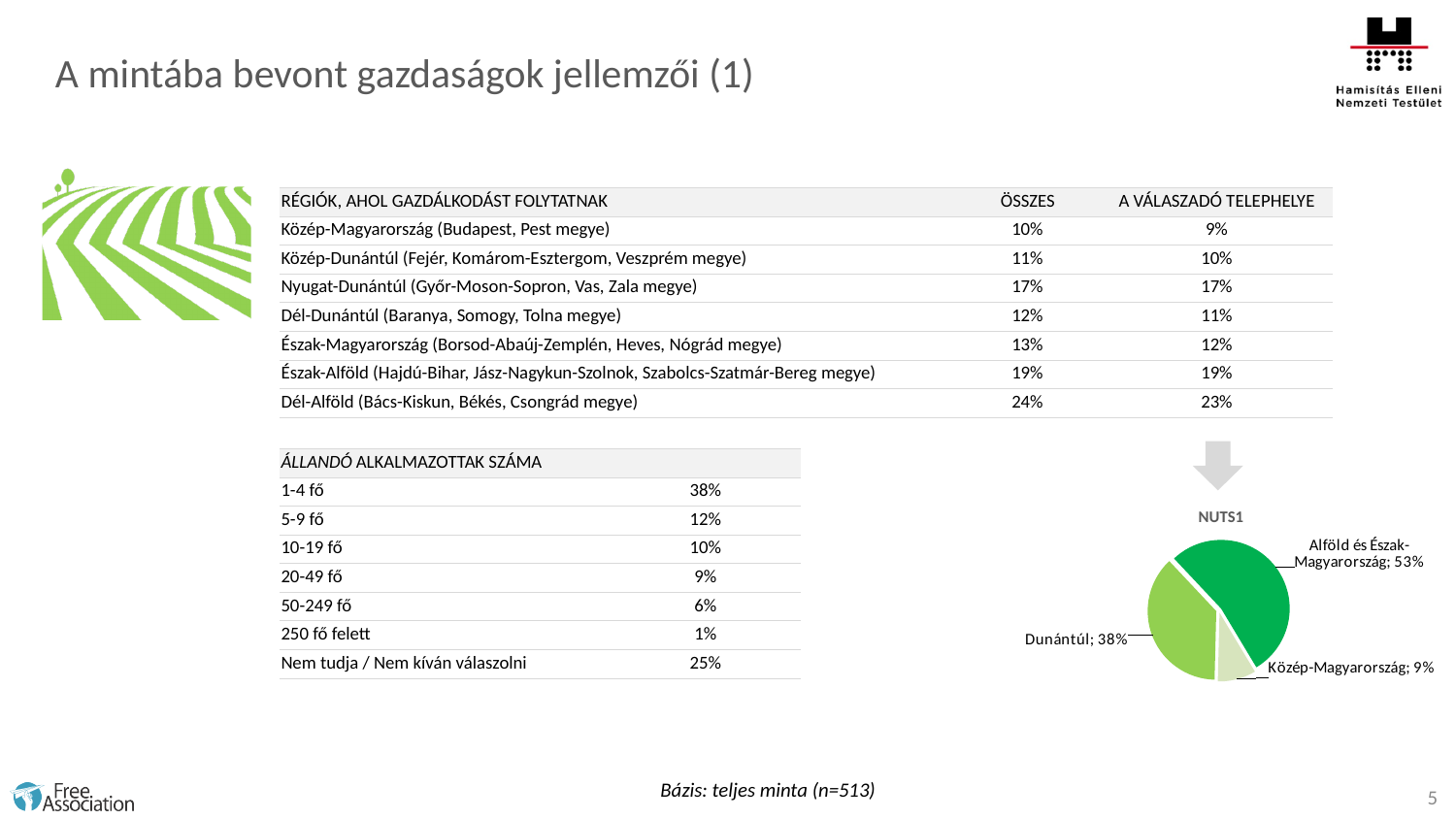
In the NUTS1 pie chart, what is the share for Dunántúl? 38% In the NUTS1 pie chart, what is the share for Közép-Magyarország? 9% Which slice of the NUTS1 pie chart is the largest? Alföld és Észak-Magyarország Which slice of the NUTS1 pie chart is the smallest? Közép-Magyarország What is the title of the pie chart on the slide? NUTS1 What kind of chart is shown under the NUTS1 heading? Pie chart In the NUTS1 pie chart, which is larger: Dunántúl or Közép-Magyarország? Dunántúl In the NUTS1 pie chart, what is the difference between the shares of Dunántúl and Közép-Magyarország? 29% In the NUTS1 pie chart, what is the share for Alföld és Észak-Magyarország? 53% In the NUTS1 pie chart, what is the difference between the shares of Alföld és Észak-Magyarország and Dunántúl? 15% How many slices does the NUTS1 pie chart have? 3 In the NUTS1 pie chart, what is the combined share of Dunántúl and Közép-Magyarország? 47%